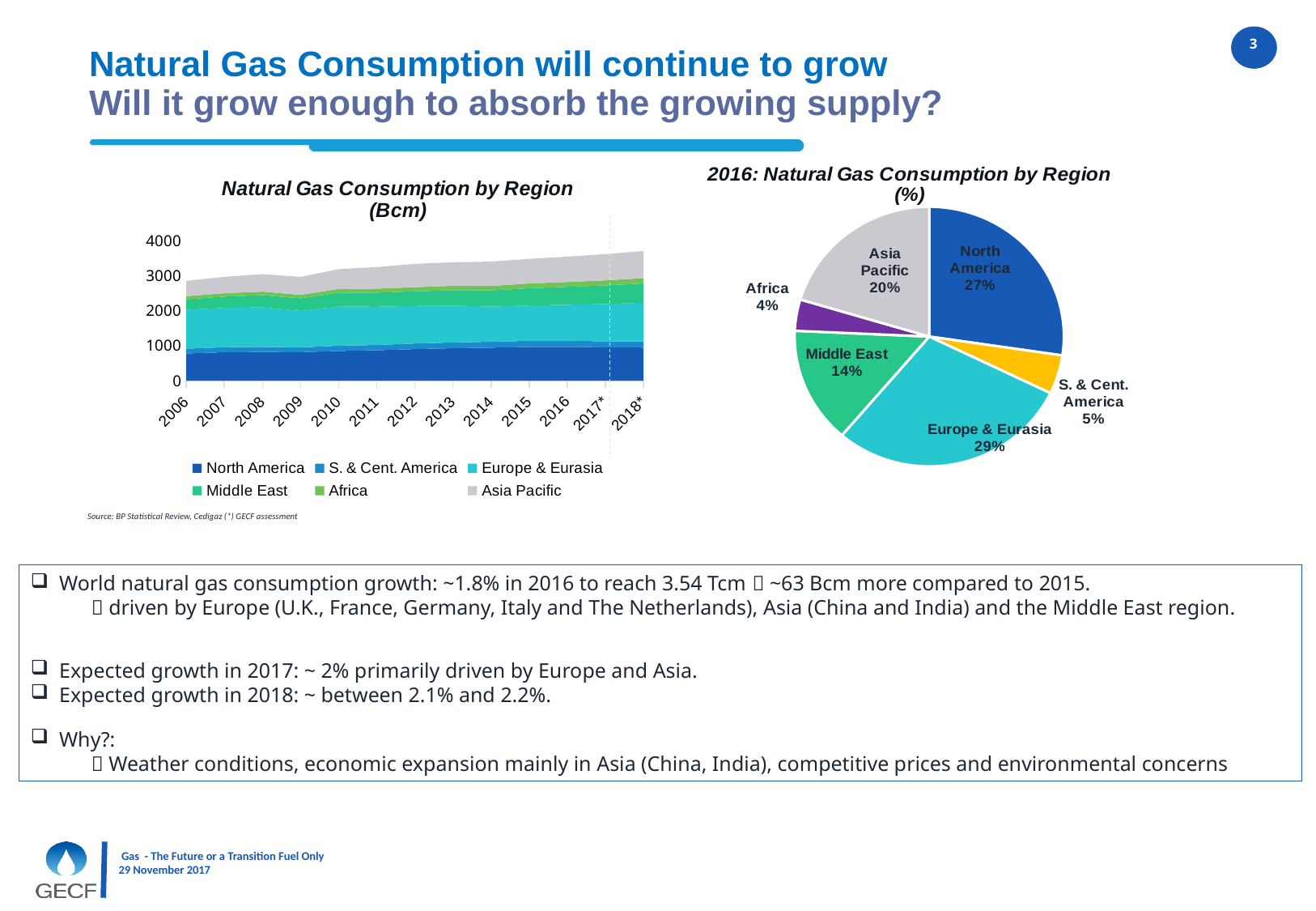
In the pie chart titled '2016: Natural Gas Consumption by Region (%)', which region has the smallest share? Africa In the pie chart titled '2016: Natural Gas Consumption by Region (%)', what share does Europe & Eurasia have? 29% In the chart titled 'Natural Gas Consumption by Region (Bcm)', how many series does the legend list? 6 In the pie chart titled '2016: Natural Gas Consumption by Region (%)', what is the difference in percentage points between North America and Middle East? 13 In the pie chart titled '2016: Natural Gas Consumption by Region (%)', how many regions are shown? 6 In the pie chart titled '2016: Natural Gas Consumption by Region (%)', which is larger, Asia Pacific or Middle East? Asia Pacific In the chart titled 'Natural Gas Consumption by Region (Bcm)', how many years are shown on the x axis? 13 In the pie chart titled '2016: Natural Gas Consumption by Region (%)', what share does Africa have? 4% What kind of chart is the chart titled 'Natural Gas Consumption by Region (Bcm)'? Stacked area chart In the pie chart titled '2016: Natural Gas Consumption by Region (%)', which region has the largest share? Europe & Eurasia In the chart titled 'Natural Gas Consumption by Region (Bcm)', does total consumption generally rise or fall from 2006 to 2018*? rise In the chart titled 'Natural Gas Consumption by Region (Bcm)', is the total consumption in 2016 greater or less than 3000? greater